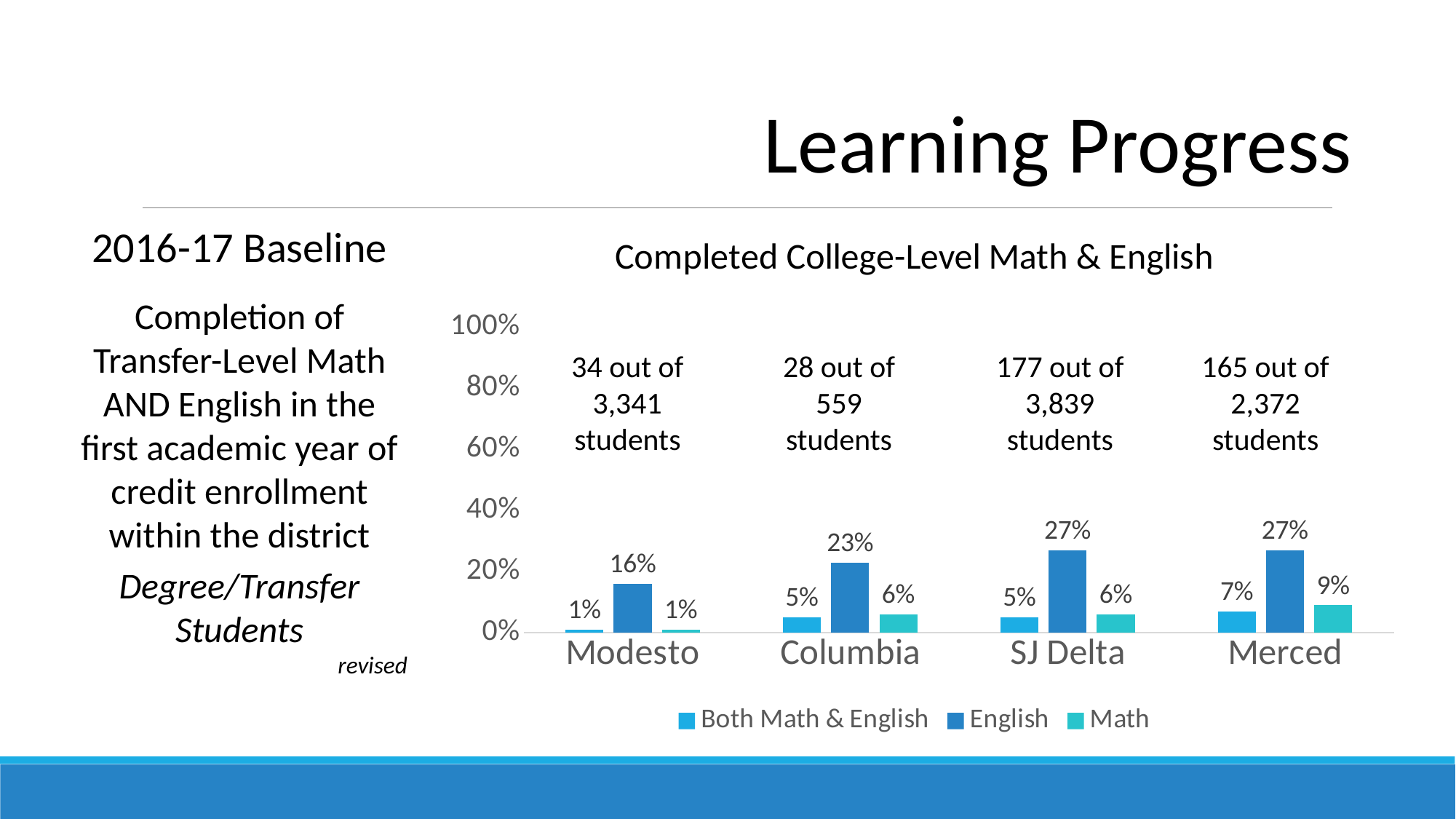
How many colleges are shown on the x axis? 4 Which college has the highest Math completion value? Merced Is the English value for Columbia greater or less than 20%? greater What is the Both Math & English value for Merced? 7% Which college has the lowest English completion value? Modesto What is the Math value for Modesto? 1% Which is larger, the Math value for Merced or the Math value for Columbia? Merced What is the difference between the English values for SJ Delta and Modesto? 11% How many series does the legend list? 3 What is the title of the chart? Completed College-Level Math & English What kind of chart is shown? bar chart What is the English completion value for Columbia? 23%